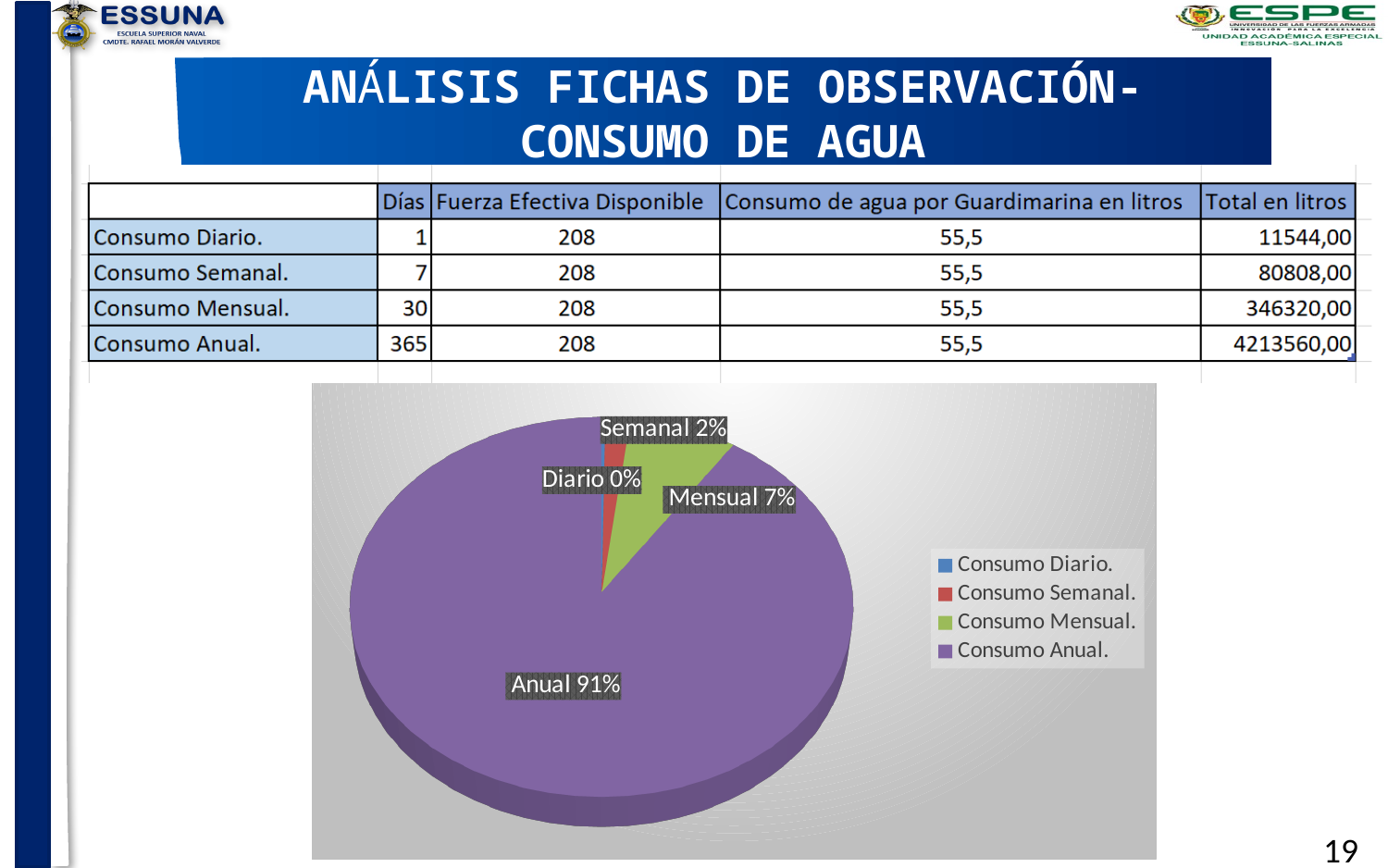
How many slices does the pie chart have? 4 What colour is the Consumo Anual slice in the pie chart? purple How many entries does the legend of the pie chart list? 4 What share of the pie does Diario represent? 0% Which slice of the pie chart is the smallest? Diario What share of the pie does Semanal represent? 2% What share of the pie does Mensual represent? 7% Which is larger in the pie chart, the Mensual slice or the Semanal slice? Mensual What is the difference in percentage points between the Anual slice and the Mensual slice? 84 What kind of chart is shown on the slide? pie chart Which slice of the pie chart is the largest? Anual